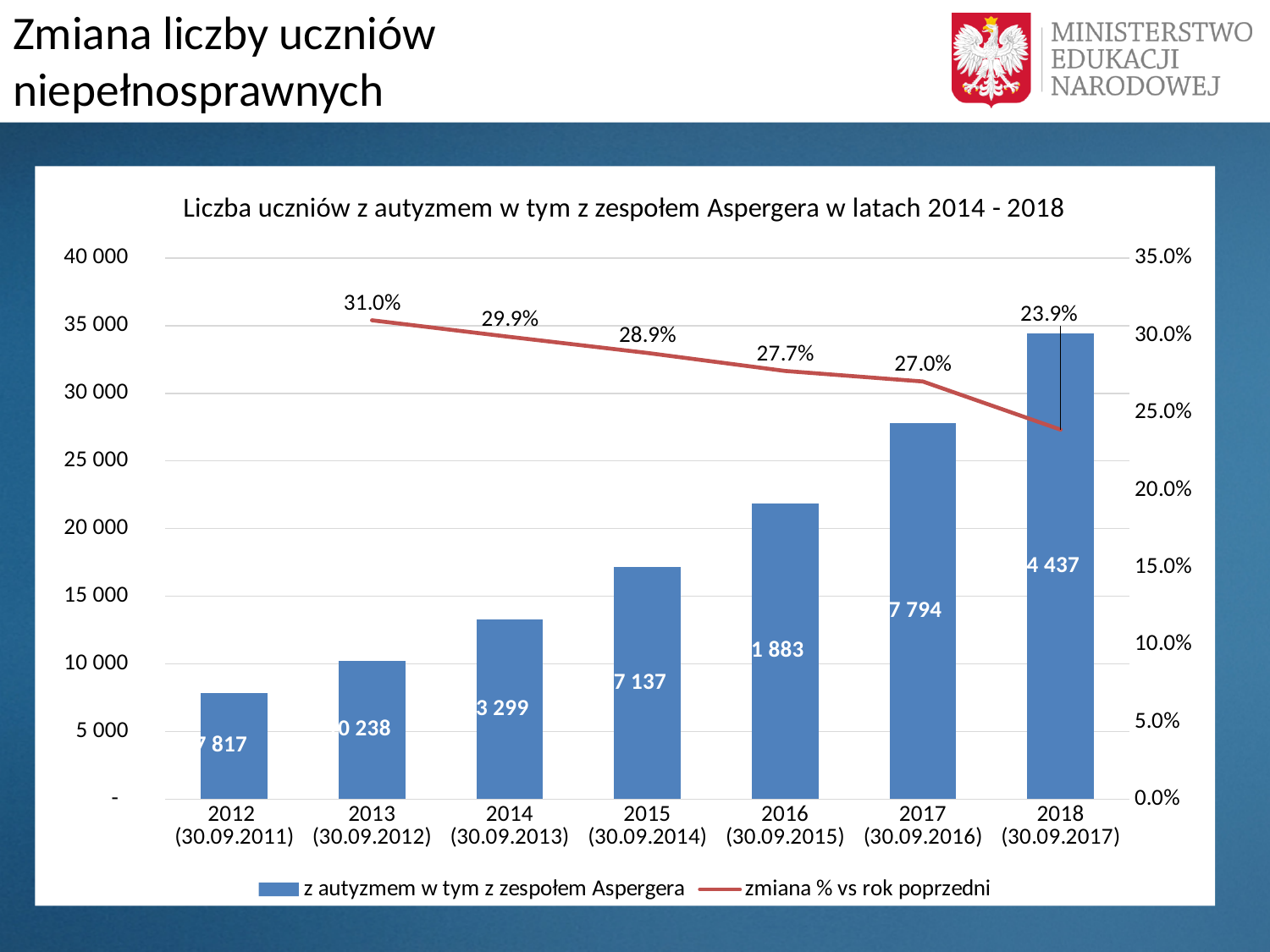
How many series does the legend list? 2 In which year is the 'zmiana % vs rok poprzedni' line at its highest? 2013 (30.09.2012) Is the bar for 2018 (30.09.2017) greater or less than 30 000? greater Which is larger, the 'zmiana % vs rok poprzedni' value for 2016 or for 2017? 2016 What is the value of the 'zmiana % vs rok poprzedni' line for 2018 (30.09.2017)? 23.9% How many years (bars) are shown on the x axis? 7 Is the bar for 2012 (30.09.2011) greater or less than 10 000? less In which year is the 'zmiana % vs rok poprzedni' line at its lowest? 2018 (30.09.2017) What is the value of the 'zmiana % vs rok poprzedni' line for 2013 (30.09.2012)? 31.0% By how many percentage points does the 'zmiana % vs rok poprzedni' value for 2013 exceed the value for 2018? 7.1 percentage points Do the bars for 'z autyzmem w tym z zespołem Aspergera' rise or fall from 2012 to 2018? rise What is the value of the 'zmiana % vs rok poprzedni' line for 2016 (30.09.2015)? 27.7%